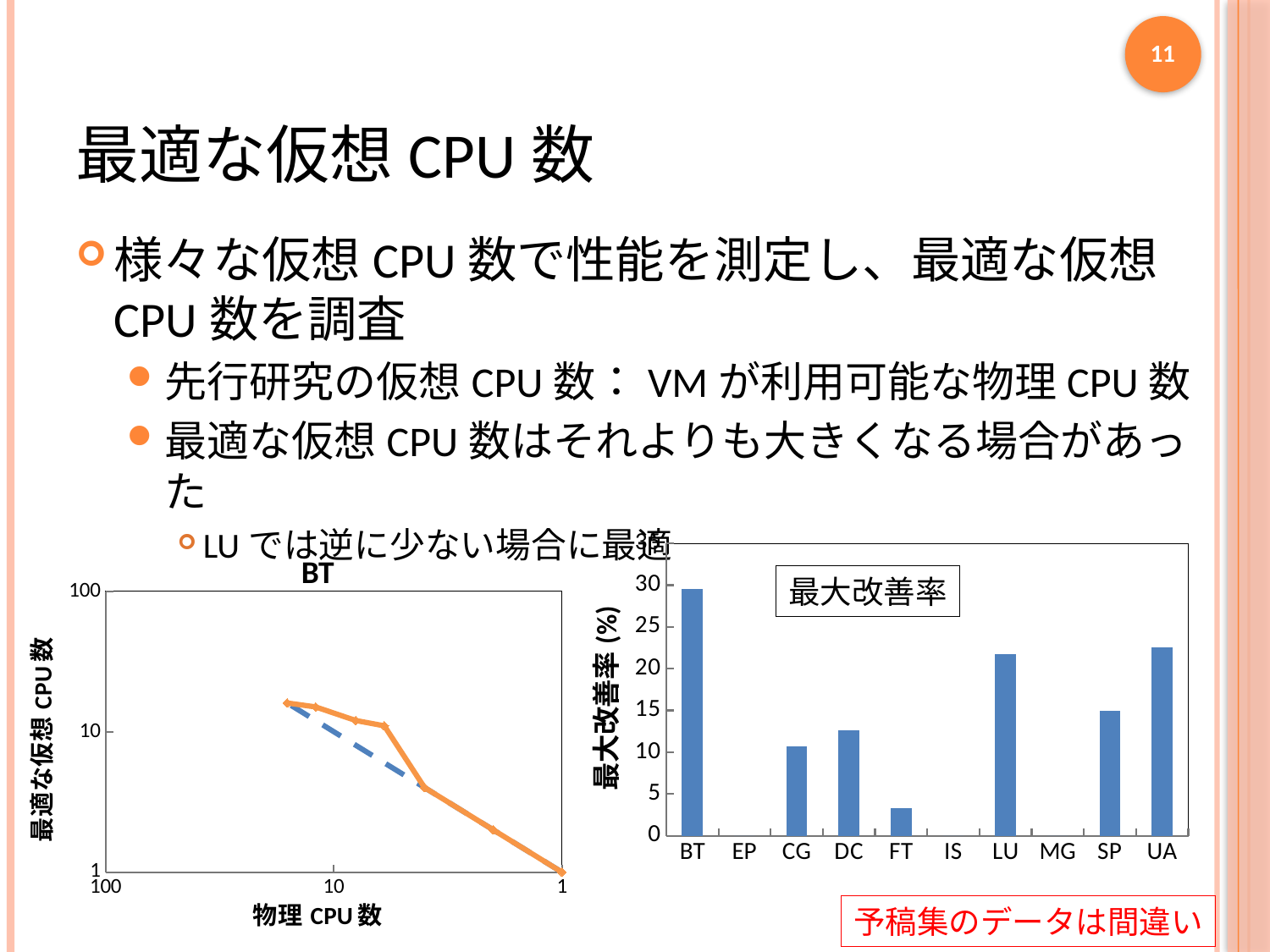
In the 最大改善率 bar chart, how many categories are shown on the x axis? 10 In the 最大改善率 bar chart, which category has the highest value? BT What kind of chart is the chart on the left of the slide titled BT? line chart What is the y-axis label of the 最大改善率 bar chart? 最大改善率 (%) What kind of chart is the chart on the right of the slide (最大改善率)? bar chart In the 最大改善率 bar chart, is the value for BT greater or less than 25? greater In the 最大改善率 bar chart, which is larger, the value for DC or the value for FT? DC What is the x-axis label of the line chart titled BT on the left of the slide? 物理 CPU 数 In the 最大改善率 bar chart, is the value for FT greater or less than 5? less In the 最大改善率 bar chart, which is larger, the value for BT or the value for UA? BT In the 最大改善率 bar chart, is the value for CG greater or less than 15? less